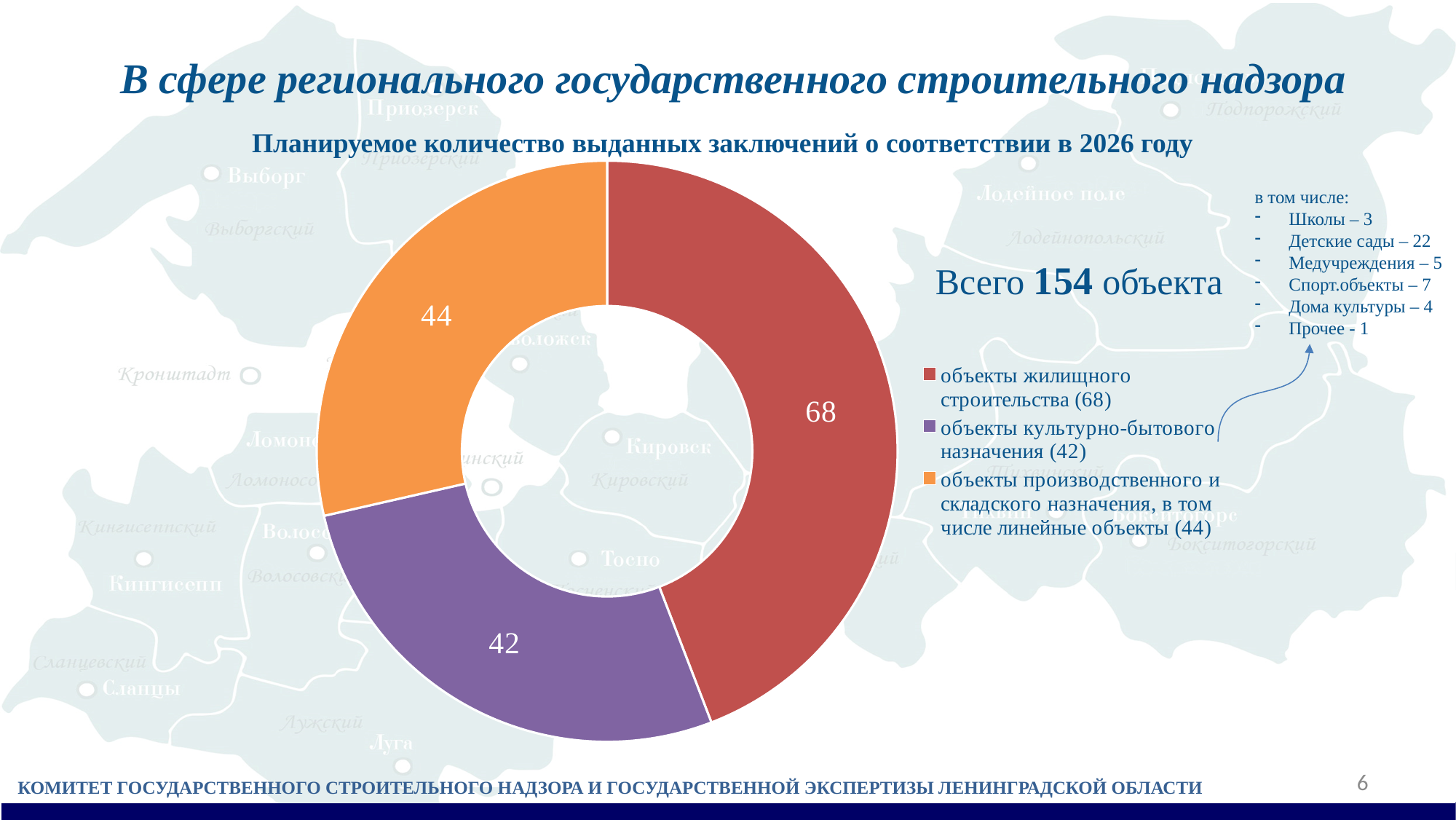
Which category has the smallest slice in the chart? объекты культурно-бытового назначения Which category has the largest slice in the chart? объекты жилищного строительства What is the value for объекты жилищного строительства in the donut chart? 68 What is the difference between the values for объекты жилищного строительства and объекты производственного и складского назначения? 24 What kind of chart is shown on the slide? Donut (pie) chart How many categories are shown in the chart? 3 What is the value for объекты производственного и складского назначения, в том числе линейные объекты? 44 What is the total number of objects across all slices of the chart? 154 What is the difference between the values for объекты жилищного строительства and объекты культурно-бытового назначения? 26 Which is larger: объекты производственного и складского назначения or объекты культурно-бытового назначения? объекты производственного и складского назначения What is the value for объекты культурно-бытового назначения in the donut chart? 42 What is the title of the chart? Планируемое количество выданных заключений о соответствии в 2026 году